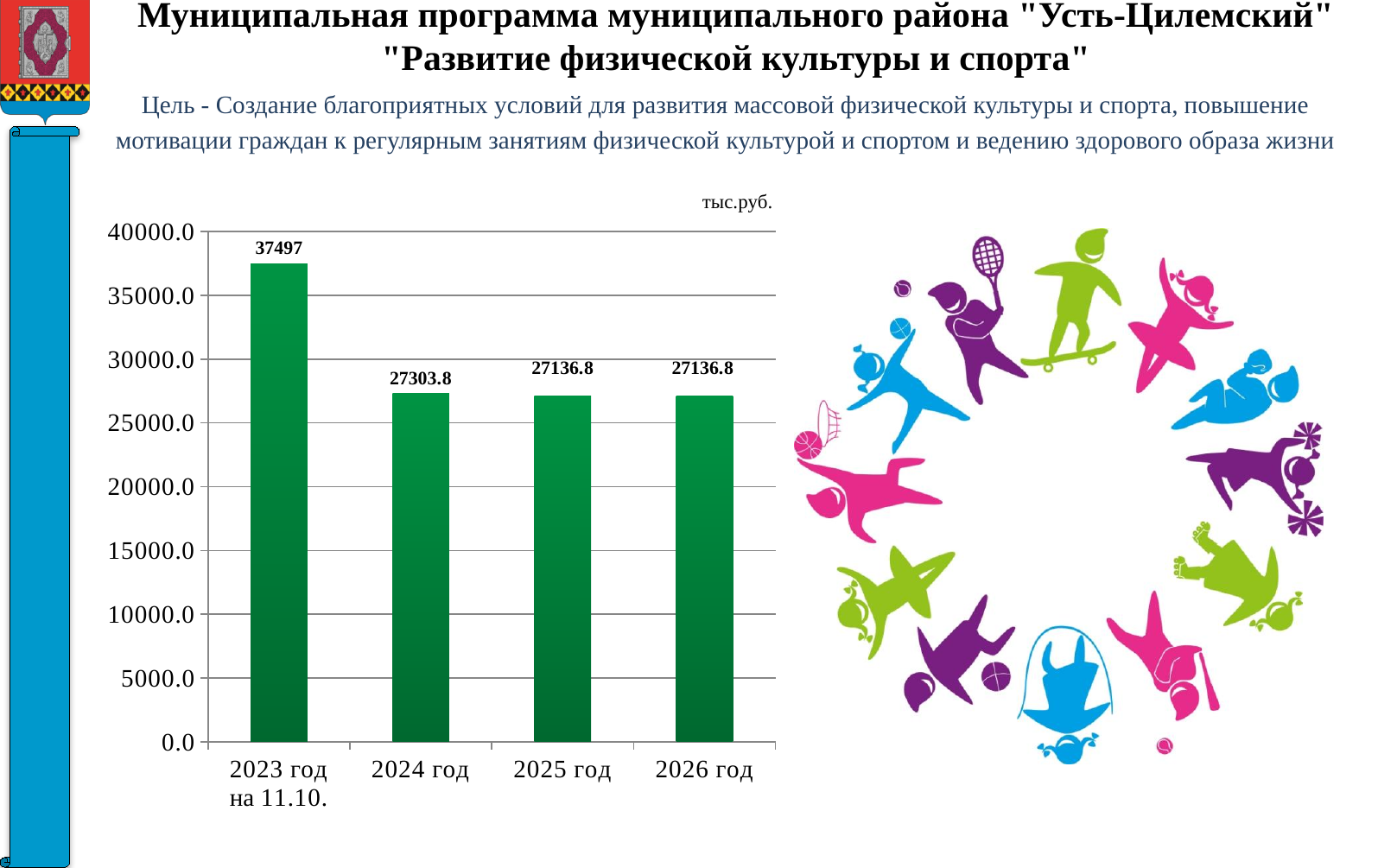
How many categories are shown on the x axis? 4 What is the difference between the values for 2024 год and 2025 год? 167 What unit label is shown above the chart? тыс.руб. What is the value for 2024 год? 27303.8 What is the difference between the values for 2023 год на 11.10. and 2024 год? 10193.2 What is the value for 2023 год на 11.10.? 37497 Which year has the highest value? 2023 год на 11.10. Is the value for 2024 год greater or less than 30000.0? less Which is larger, the value for 2023 год на 11.10. or the value for 2026 год? 2023 год на 11.10. What is the value for 2025 год? 27136.8 What is the value for 2026 год? 27136.8 What kind of chart is shown on the slide? bar chart